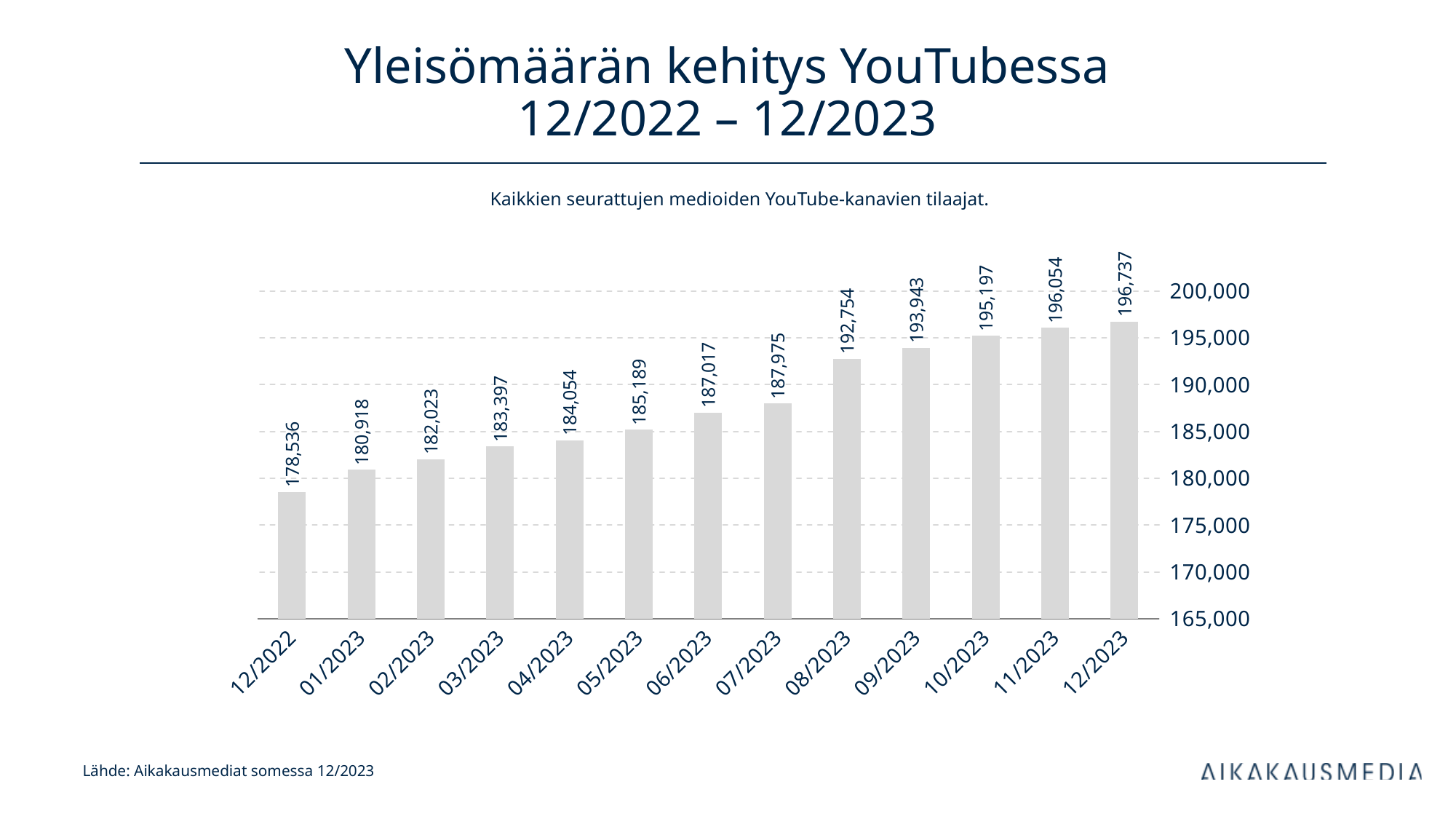
Do the values rise or fall from 12/2022 to 12/2023? rise How many months are shown on the x axis? 13 Is the value for 10/2023 greater or less than 190,000? greater Which month has the highest value? 12/2023 Which month has the lowest value? 12/2022 What is the value for 12/2023? 196,737 What is the value for 12/2022? 178,536 What is the value for 06/2023? 187,017 What is the difference between the values for 12/2023 and 12/2022? 18,201 Which is larger, the value for 03/2023 or the value for 09/2023? 09/2023 What kind of chart is shown on the slide? bar chart What is the difference between the values for 08/2023 and 07/2023? 4,779